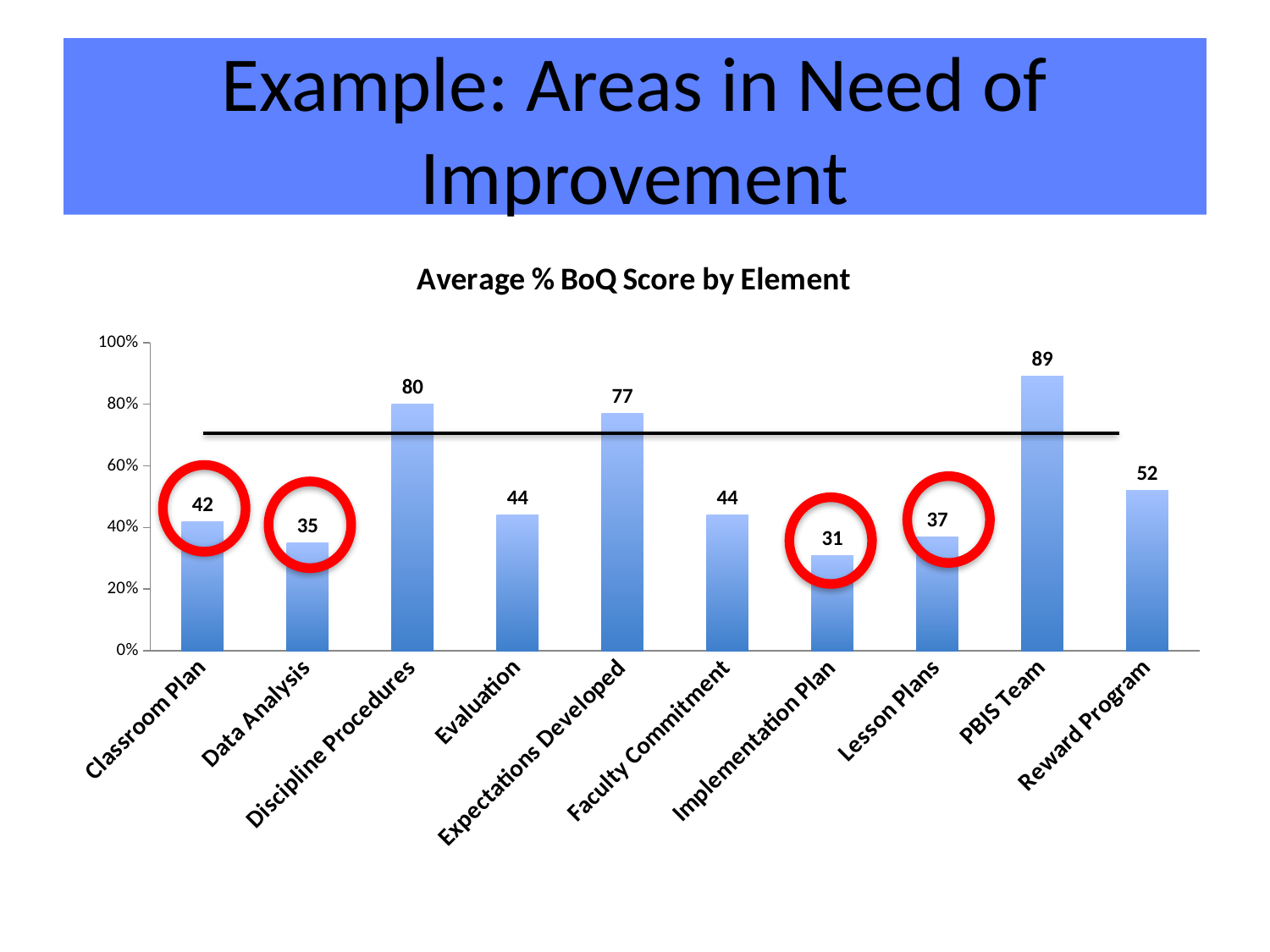
How many bars are circled in red? 4 How many elements are shown on the x axis? 10 What is the difference between the values for Discipline Procedures and Data Analysis? 45 Which element has the lowest value? Implementation Plan What is the title of the chart? Average % BoQ Score by Element Which element has the highest value? PBIS Team What is the value for Classroom Plan? 42 What is the value for PBIS Team? 89 What kind of chart is this? Bar chart What is the value for Implementation Plan? 31 Which is larger, the value for Reward Program or the value for Lesson Plans? Reward Program Is the value for Expectations Developed greater or less than 60%? greater